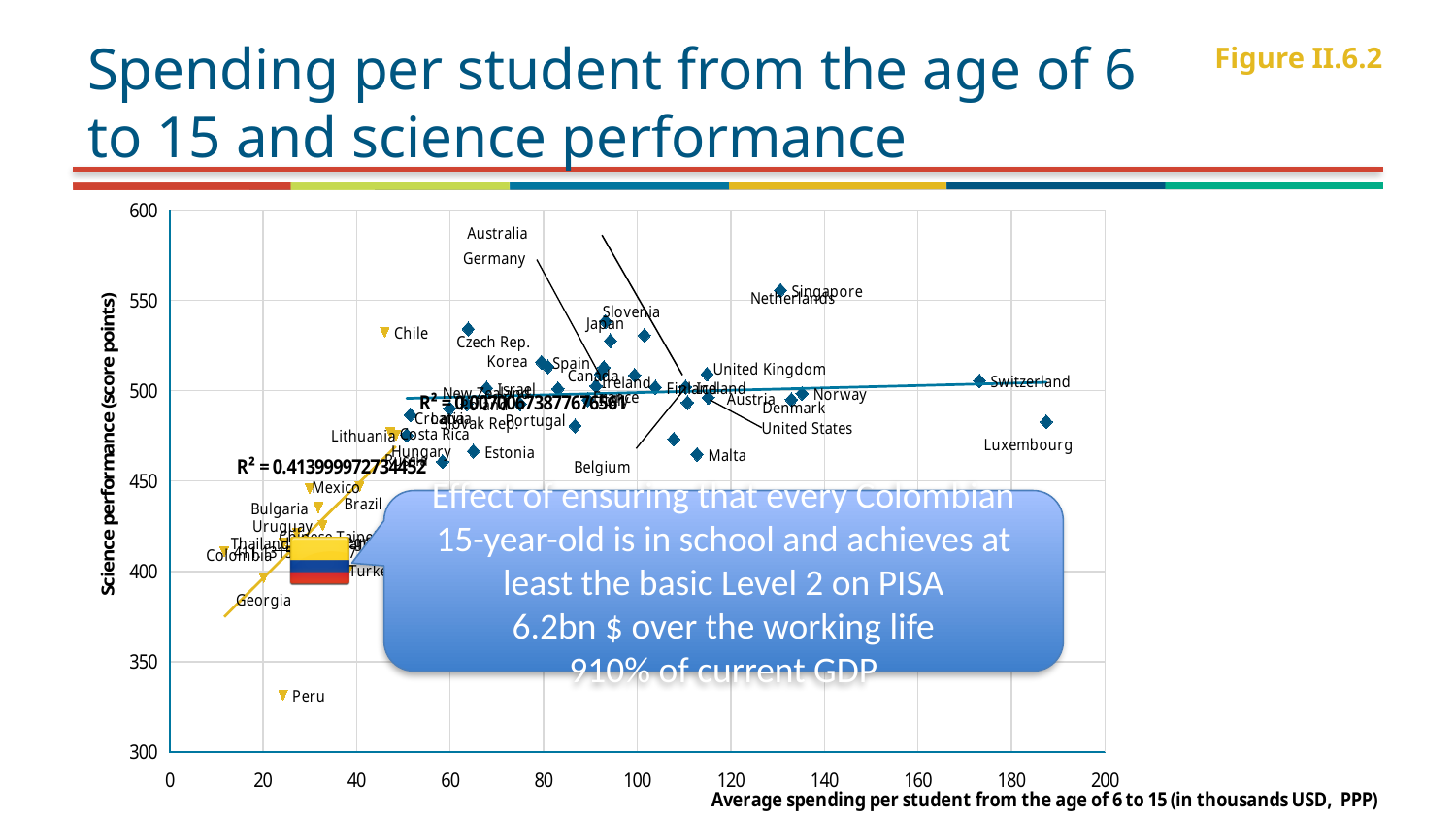
Is the science performance value for Peru greater or less than 350? less Is the science performance value for Singapore greater or less than 550? greater Which country has the lowest science performance on the chart? Peru Which country has the highest average spending per student on the chart? Luxembourg Does science performance generally rise or fall as average spending per student increases along the x axis? rise What is the label of the vertical axis? Science performance (score points) Which country has the highest science performance on the chart? Singapore Is the average spending per student for Luxembourg greater or less than 180? greater Which has the higher average spending per student, Luxembourg or Switzerland? Luxembourg Which has the higher science performance, Singapore or Luxembourg? Singapore What kind of chart is shown on the slide? scatter chart